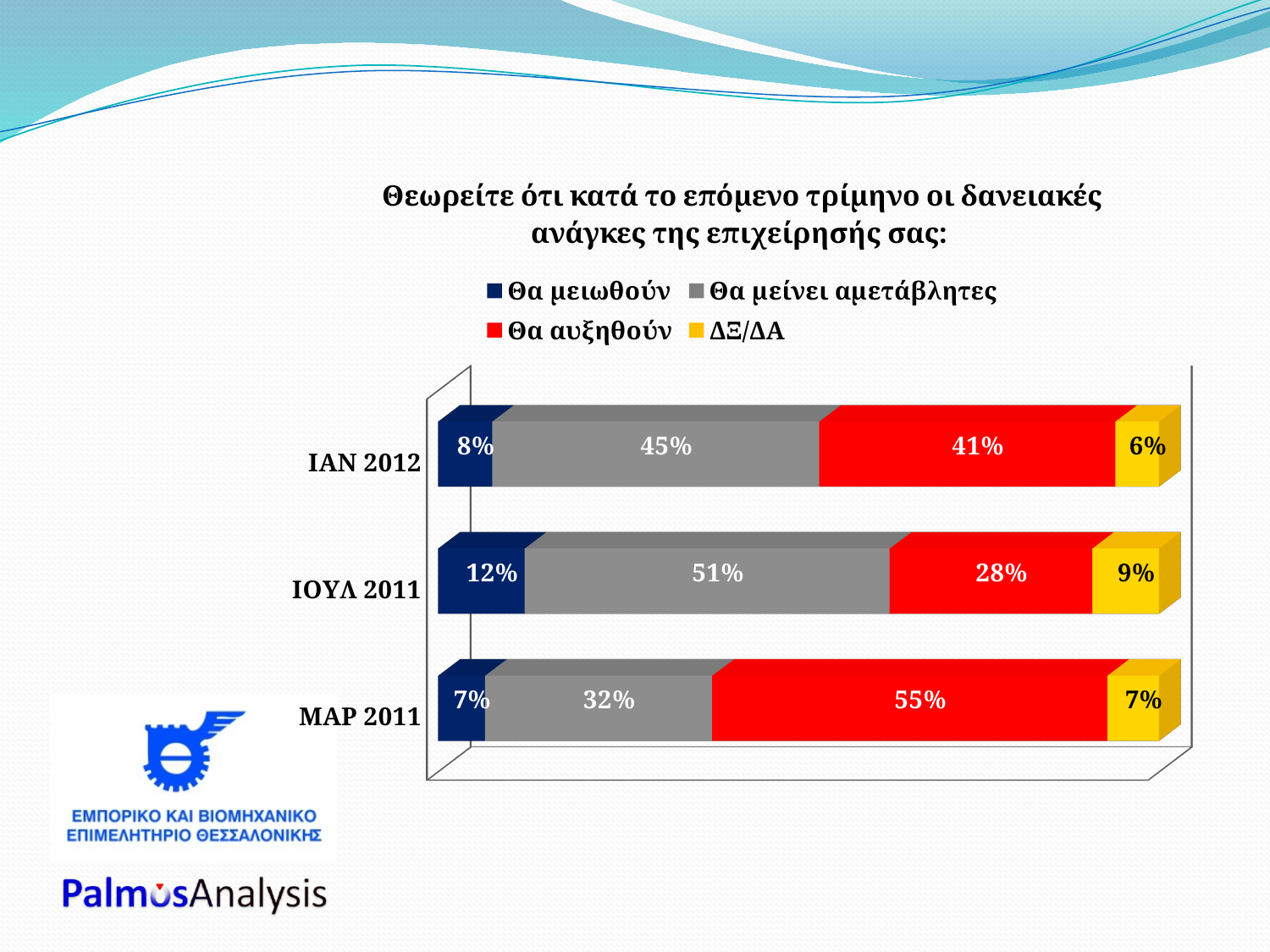
Which is larger: 'Θα μειωθούν' in ΙΑΝ 2012 or in ΙΟΥΛ 2011? ΙΟΥΛ 2011 Which colour represents 'ΔΞ/ΔΑ' in the chart? Yellow What is the value for 'Θα αυξηθούν' in ΜΑΡ 2011? 55% What is the difference between the 'Θα αυξηθούν' values for ΙΑΝ 2012 and ΙΟΥΛ 2011? 13% How many periods (categories) are shown on the chart? 3 How many series does the legend list? 4 In which period is the 'Θα μείνει αμετάβλητες' share lowest? ΜΑΡ 2011 What kind of chart is shown on the slide? Stacked bar chart What percentage of respondents in ΙΑΝ 2012 answered 'Θα μείνει αμετάβλητες'? 45% What is the value for 'ΔΞ/ΔΑ' in ΙΑΝ 2012? 6% In which period is the 'Θα αυξηθούν' share highest? ΜΑΡ 2011 What is the value for 'Θα μειωθούν' in ΙΟΥΛ 2011? 12%